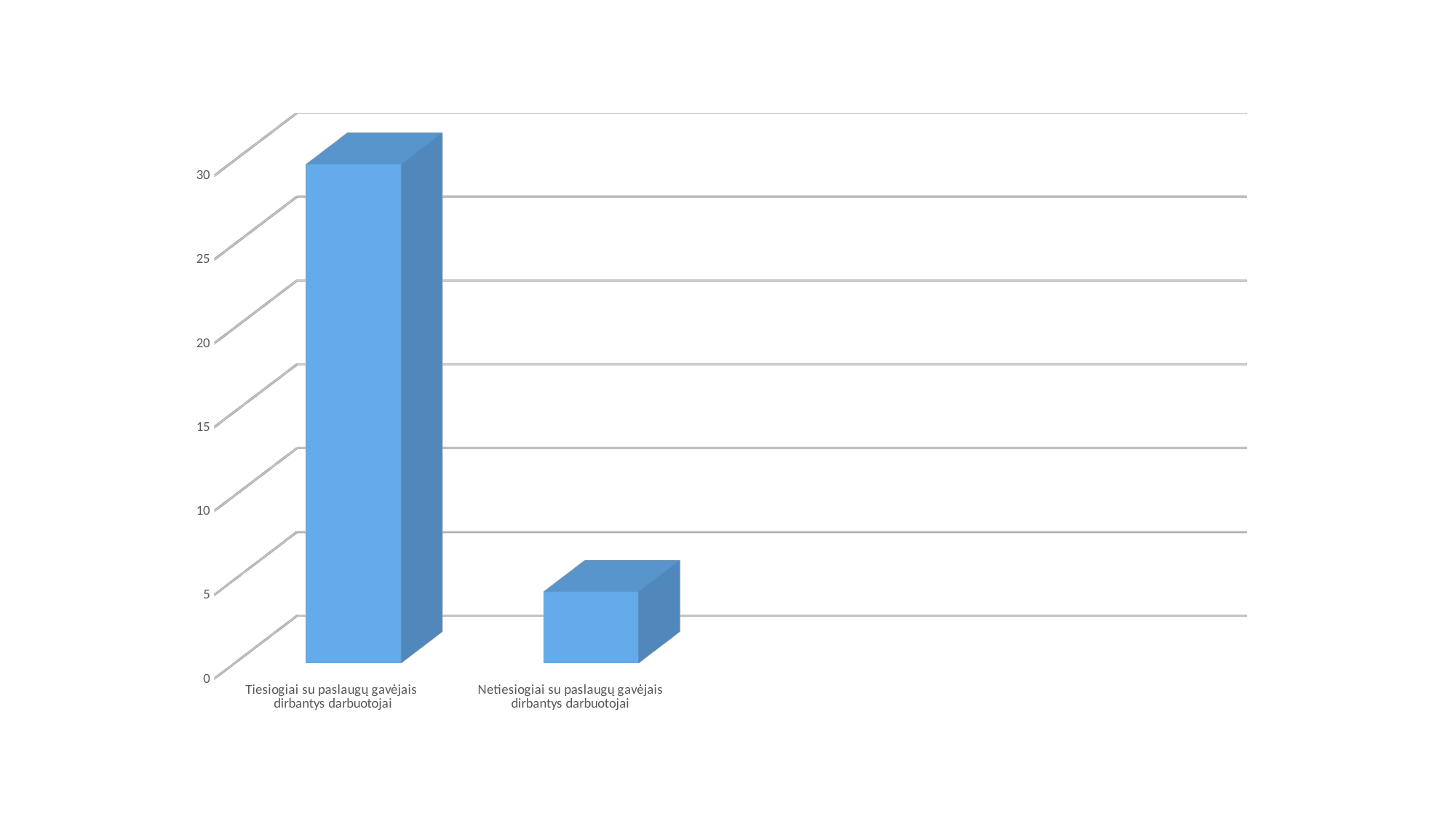
Is the value for 'Tiesiogiai su paslaugų gavėjais dirbantys darbuotojai' greater or less than 20? greater Do the values rise or fall from left to right along the x axis? fall Is the value for 'Tiesiogiai su paslaugų gavėjais dirbantys darbuotojai' greater or less than 25? greater Which category has the highest value in the chart? Tiesiogiai su paslaugų gavėjais dirbantys darbuotojai Is the value for 'Netiesiogiai su paslaugų gavėjais dirbantys darbuotojai' greater or less than 10? less What kind of chart is shown on the slide? bar chart What colour are the bars in the chart? blue What is the highest tick value shown on the vertical axis of the chart? 30 How many categories are shown on the x axis of the chart? 2 Which is larger: the value for 'Tiesiogiai su paslaugų gavėjais dirbantys darbuotojai' or the value for 'Netiesiogiai su paslaugų gavėjais dirbantys darbuotojai'? Tiesiogiai su paslaugų gavėjais dirbantys darbuotojai Which category has the lowest value in the chart? Netiesiogiai su paslaugų gavėjais dirbantys darbuotojai